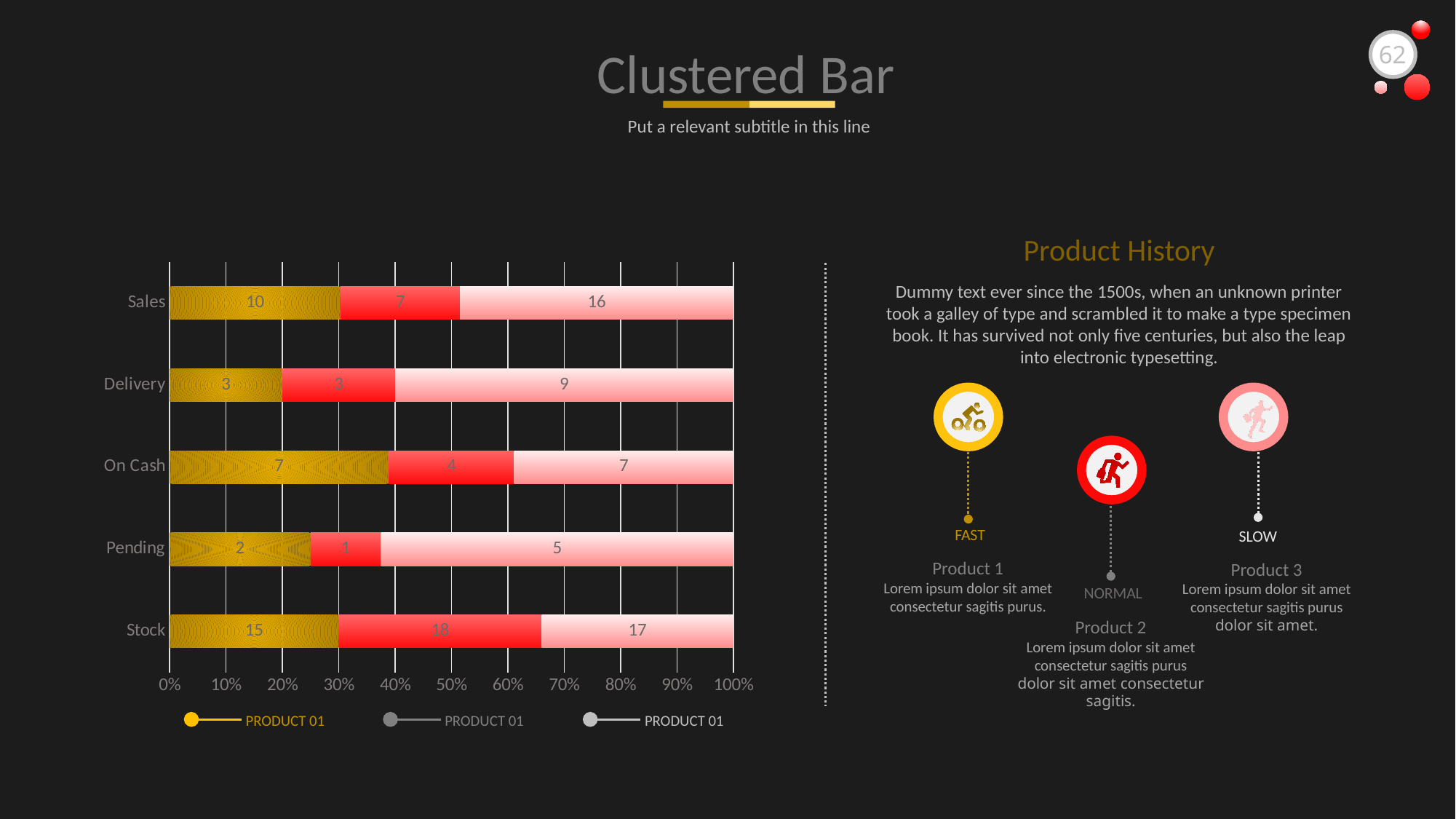
Which is larger: the gold segment value for On Cash or the gold segment value for Delivery? On Cash What is the value of the gold (first) segment for Sales? 10 What is the value of the red (middle) segment for Stock? 18 How many categories are shown on the vertical axis of the chart? 5 What is the total of the three segments in the Stock bar? 50 What is the title of the slide containing the chart? Clustered Bar What is the difference between the pink segment value for Sales and the pink segment value for Pending? 11 What kind of chart is shown on the slide? bar chart Which category has the lowest value in the red (middle) segment? Pending What is the value of the pink (last) segment for Delivery? 9 Which category has the highest value in the gold (first) segment? Stock How many series does the chart legend list? 3